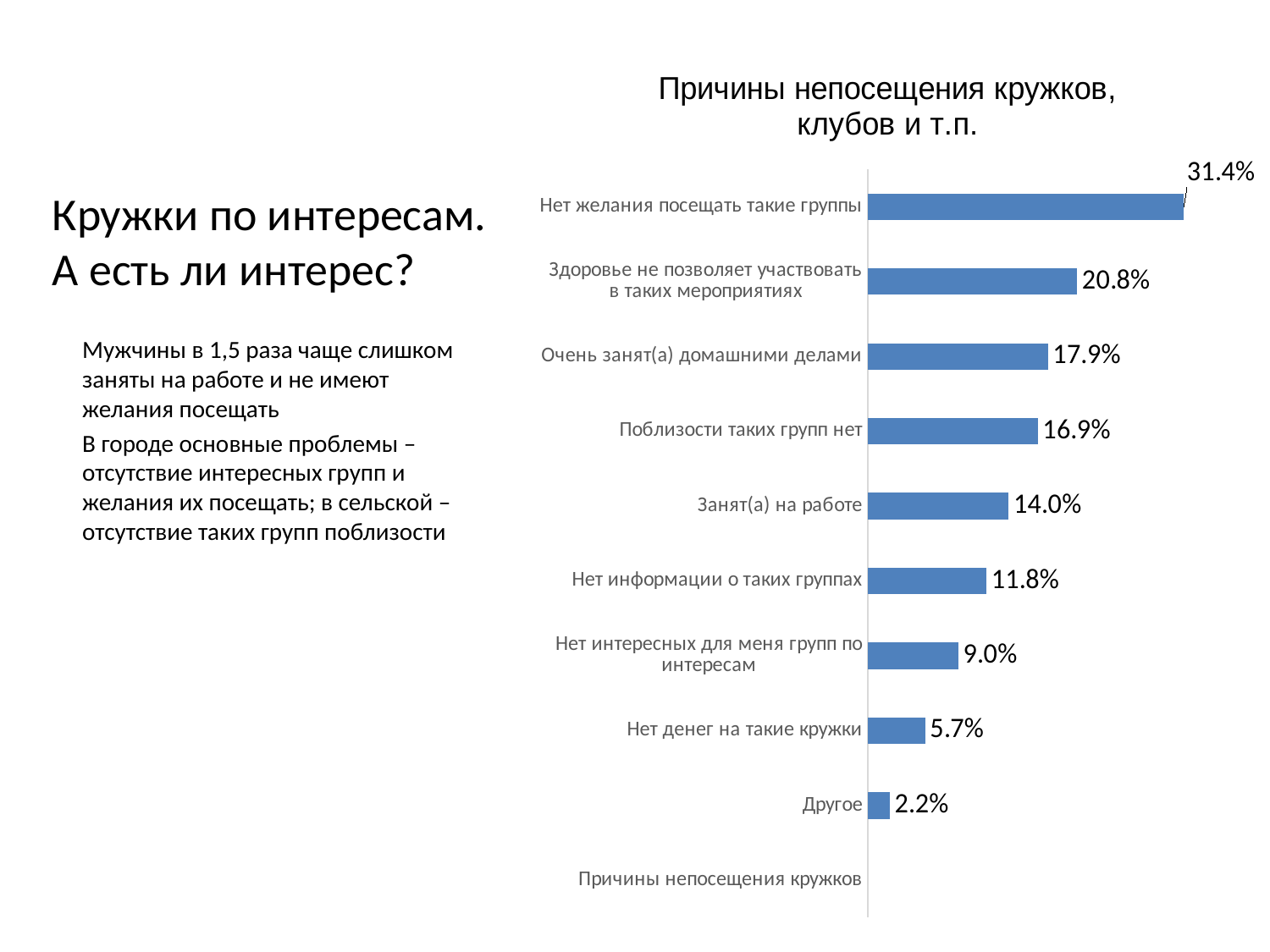
What is the value for "Здоровье не позволяет участвовать в таких мероприятиях"? 20.8% Which category has the lowest plotted value? Другое Which category has the highest value? Нет желания посещать такие группы What type of chart is shown on the slide? bar chart What is the value for "Занят(а) на работе"? 14.0% How many bars with data labels are plotted in the chart? 9 Which is larger: the value for "Нет информации о таких группах" or the value for "Нет интересных для меня групп по интересам"? Нет информации о таких группах What is the value for "Нет желания посещать такие группы"? 31.4% What is the value for "Нет денег на такие кружки"? 5.7% What is the title of the chart? Причины непосещения кружков, клубов и т.п. What is the difference between the values for "Очень занят(а) домашними делами" and "Поблизости таких групп нет"? 1.0% What is the difference between the values for "Нет желания посещать такие группы" and "Другое"? 29.2%